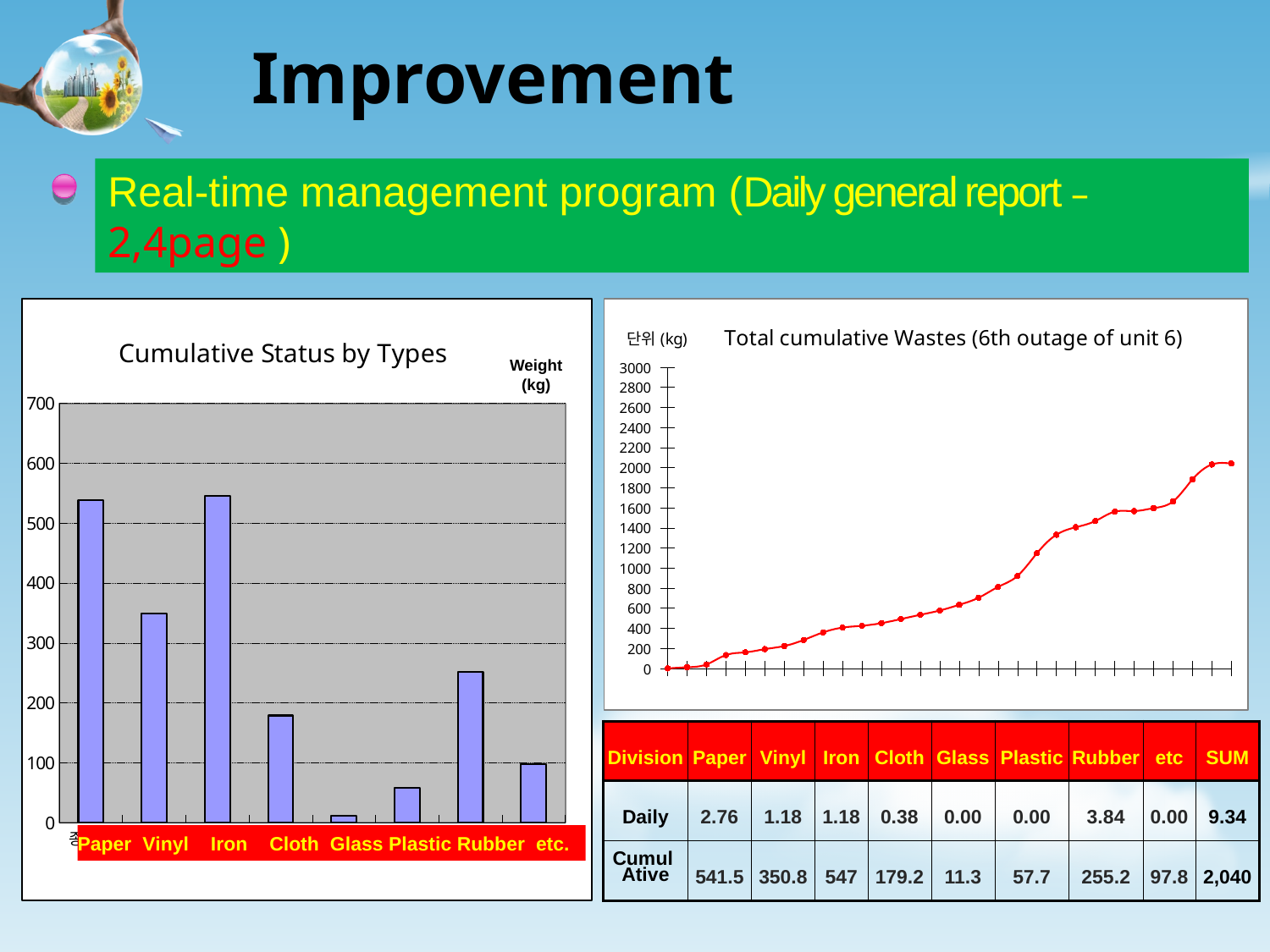
In the 'Cumulative Status by Types' chart, is the value for Paper greater or less than 500? greater In the 'Cumulative Status by Types' chart, what is the label on the vertical axis? Weight (kg) In the 'Cumulative Status by Types' chart, how many categories are shown on the x axis? 8 In the 'Cumulative Status by Types' chart, which is larger, the bar for Cloth or the bar for etc.? Cloth In the 'Cumulative Status by Types' chart, what kind of chart is used? bar chart In the 'Cumulative Status by Types' chart, which category has the lowest bar? Glass What is the title of the line chart on the right side of the slide? Total cumulative Wastes (6th outage of unit 6) In the 'Cumulative Status by Types' chart, which is larger, the bar for Vinyl or the bar for Rubber? Vinyl In the 'Total cumulative Wastes (6th outage of unit 6)' chart, is the final point greater or less than 1800? greater In the 'Cumulative Status by Types' chart, is the value for Rubber greater or less than 200? greater In the 'Total cumulative Wastes (6th outage of unit 6)' chart, do the values rise or fall along the x axis? rise